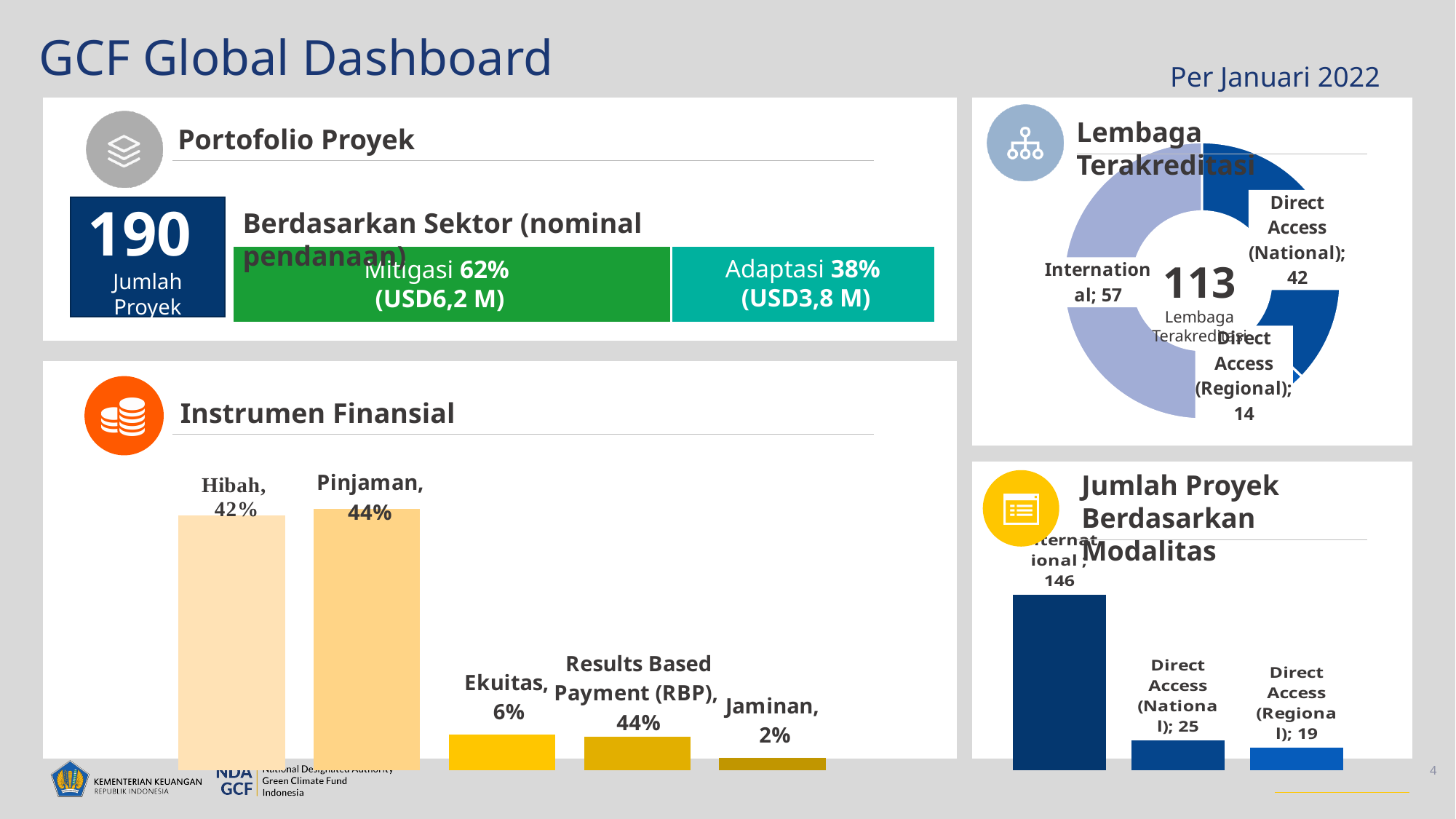
In the Instrumen Finansial chart, what is the difference between Pinjaman and Hibah? 2% In the Jumlah Proyek Berdasarkan Modalitas chart, what is the difference between Direct Access (National) and Direct Access (Regional)? 6 In the Lembaga Terakreditasi donut chart, what is the value for International? 57 In the Jumlah Proyek Berdasarkan Modalitas chart, what is the value for International? 146 In the Lembaga Terakreditasi donut chart, what is the total number of accredited entities shown in the centre? 113 In the Berdasarkan Sektor bar, what share is Adaptasi? 38% In the Instrumen Finansial chart, which category has the lowest value? Jaminan In the Lembaga Terakreditasi donut chart, which segment is the smallest? Direct Access (Regional) In the Instrumen Finansial chart, which is larger, Ekuitas or Jaminan? Ekuitas In the Instrumen Finansial chart, what is the value for Hibah? 42% In the Jumlah Proyek Berdasarkan Modalitas chart, how many categories are shown? 3 In the Instrumen Finansial chart, what is the value for Jaminan? 2%